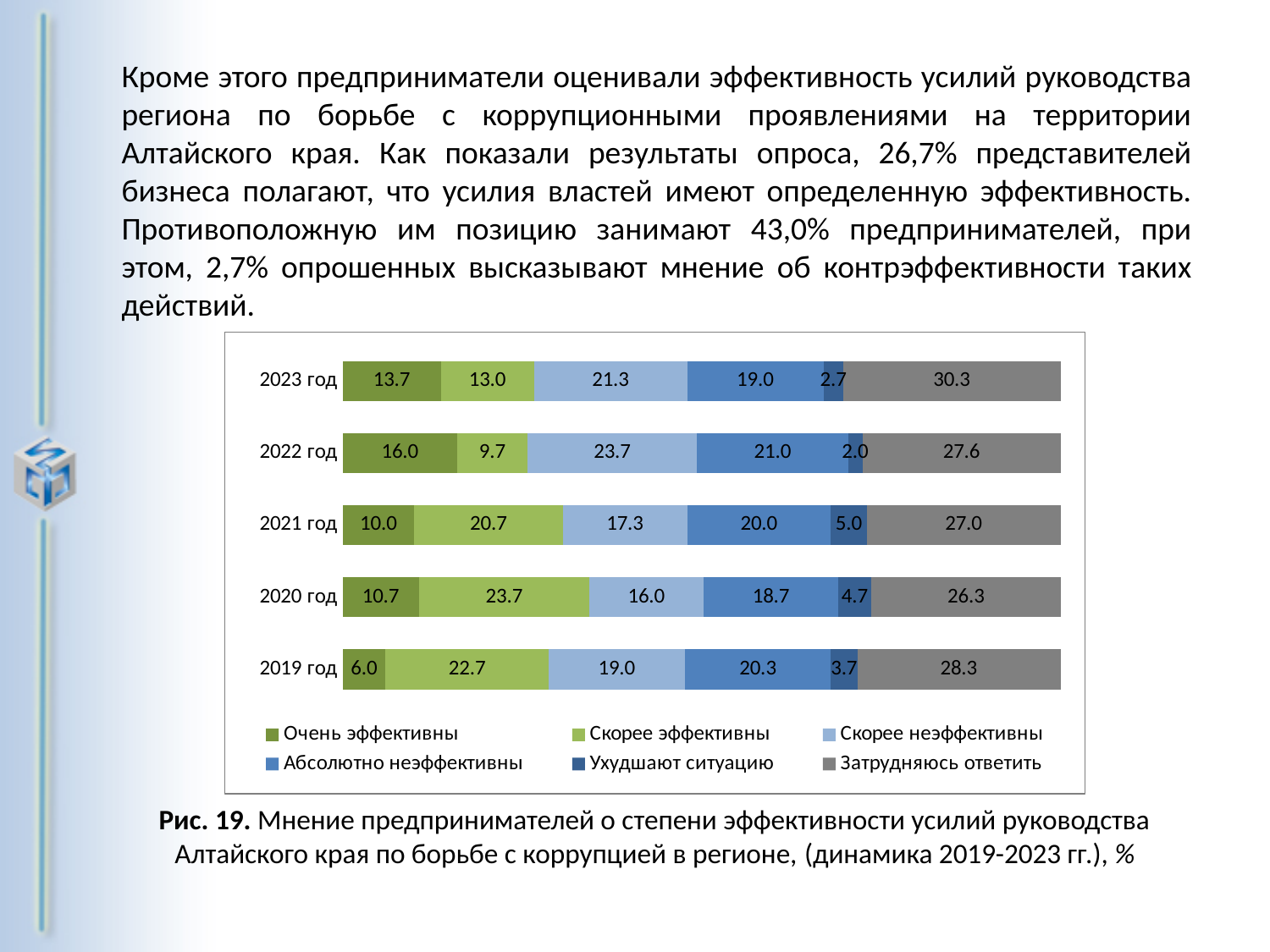
What is the difference between the "Скорее неэффективны" values for 2022 год and 2023 год? 2.4 In which year is the value for "Очень эффективны" the lowest? 2019 год What is the value for "Ухудшают ситуацию" in 2021 год? 5.0 How many years (categories) are shown in the chart? 5 What is the value for "Затрудняюсь ответить" in 2020 год? 26.3 How many series does the legend list? 6 In which year is the value for "Очень эффективны" the highest? 2022 год Which is larger: "Скорее эффективны" in 2019 год or "Скорее эффективны" in 2022 год? 2019 год What is the total of the stacked bar for 2021 год? 100.0 In which year is the value for "Затрудняюсь ответить" the highest? 2023 год What is the value for "Очень эффективны" in 2023 год? 13.7 What type of chart is shown on the slide? stacked bar chart